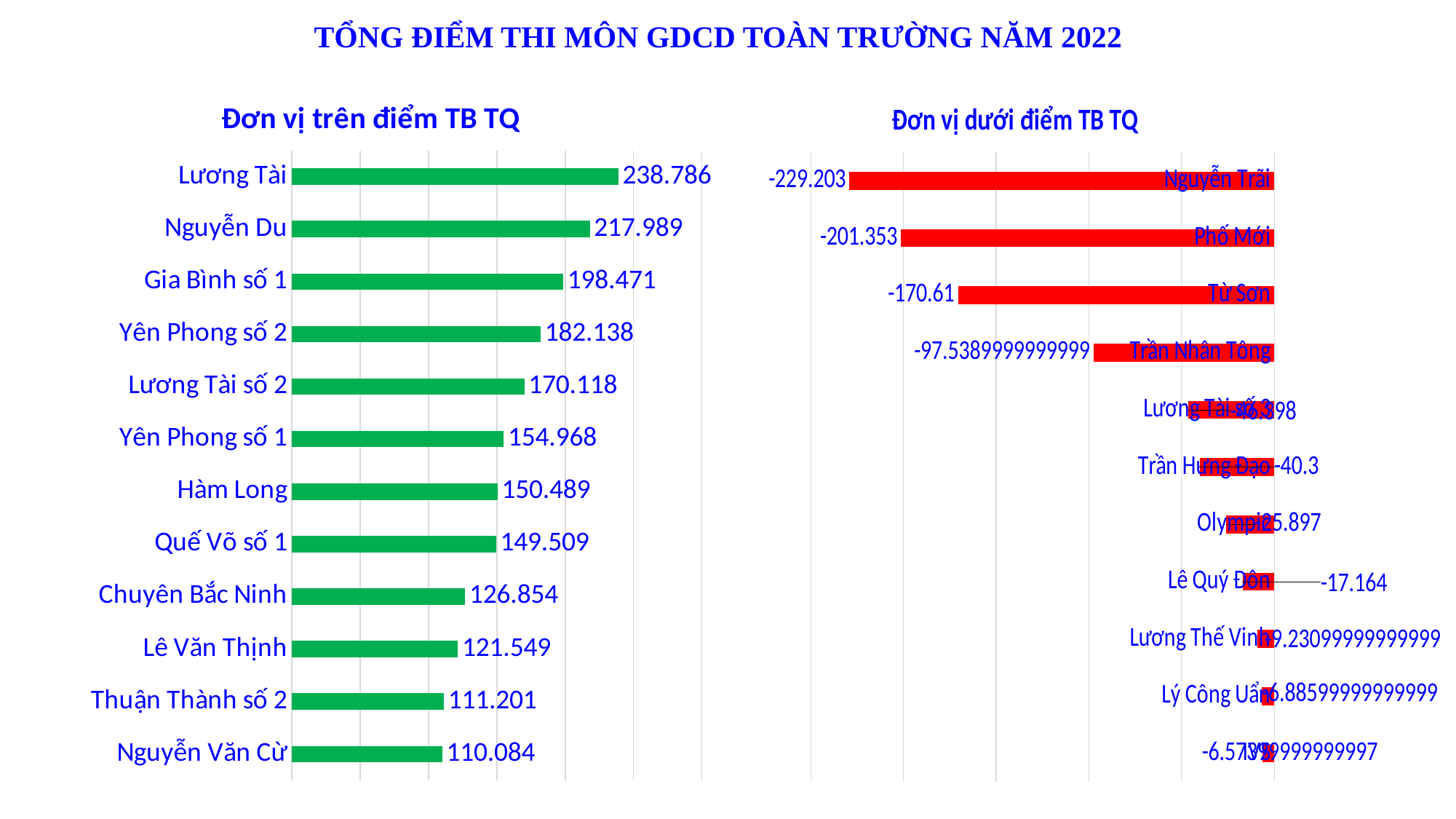
In the chart titled 'Đơn vị dưới điểm TB TQ', what is the value for Nguyễn Trãi? -229.203 How many categories are shown in the chart titled 'Đơn vị trên điểm TB TQ'? 12 In the chart titled 'Đơn vị dưới điểm TB TQ', what is the value for Từ Sơn? -170.61 What colour are the bars in the chart titled 'Đơn vị dưới điểm TB TQ'? Red In the chart titled 'Đơn vị trên điểm TB TQ', which category has the highest value? Lương Tài In the chart titled 'Đơn vị trên điểm TB TQ', what is the value for Lương Tài? 238.786 What type of chart is the chart titled 'Đơn vị trên điểm TB TQ'? Bar chart In the chart titled 'Đơn vị trên điểm TB TQ', which category has the lowest value? Nguyễn Văn Cừ In the chart titled 'Đơn vị trên điểm TB TQ', which is larger: the value for Yên Phong số 2 or the value for Lương Tài số 2? Yên Phong số 2 In the chart titled 'Đơn vị trên điểm TB TQ', what is the value for Hàm Long? 150.489 In the chart titled 'Đơn vị trên điểm TB TQ', what is the difference between the values for Nguyễn Du and Gia Bình số 1? 19.518 In the chart titled 'Đơn vị dưới điểm TB TQ', what is the difference between the values for Nguyễn Trãi and Phố Mới? 27.85